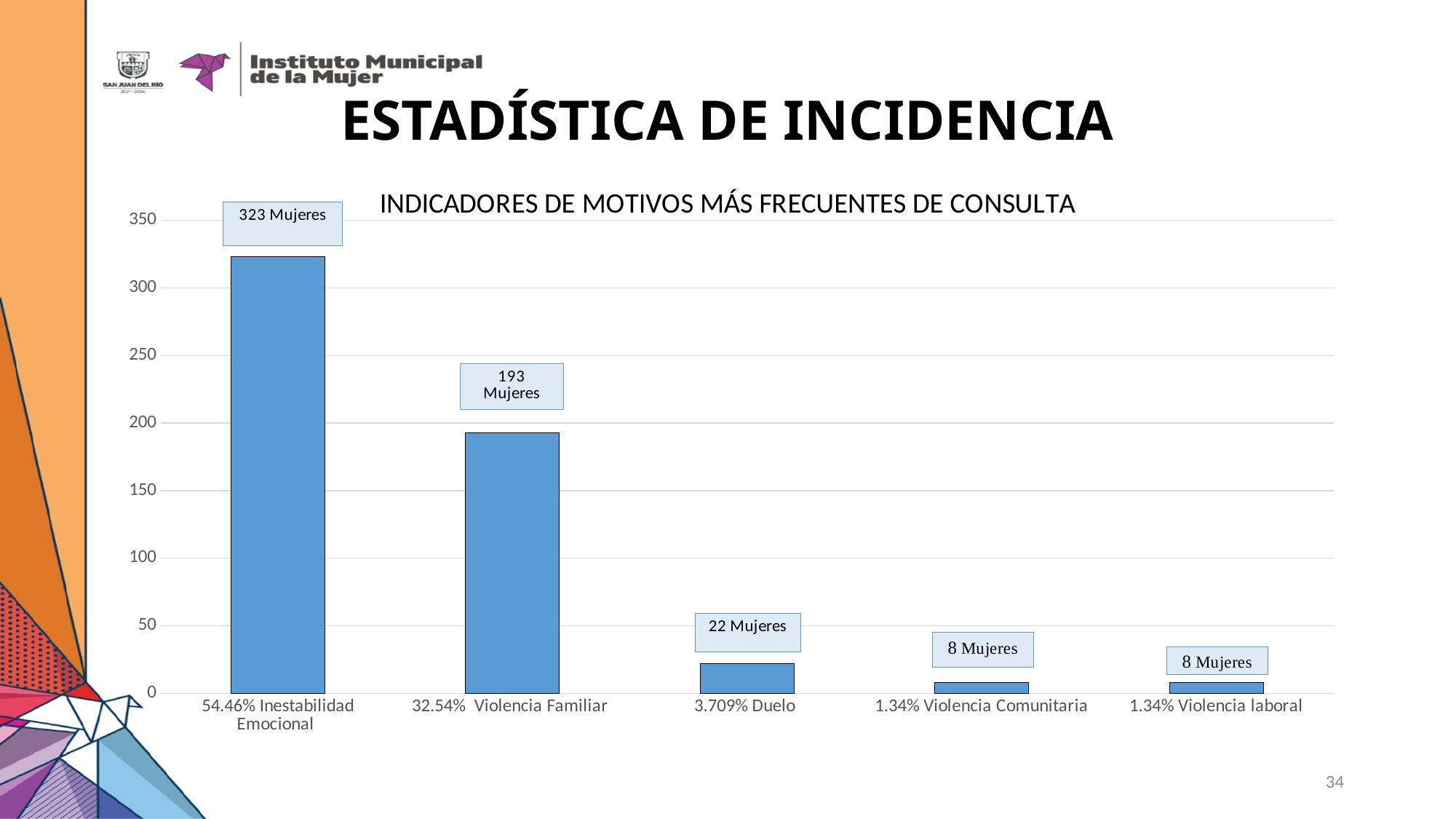
What is the title of the chart? INDICADORES DE MOTIVOS MÁS FRECUENTES DE CONSULTA Is the value for Violencia Familiar greater or less than 150? greater What is the value shown for Inestabilidad Emocional? 323 Mujeres How many categories are shown on the x axis? 5 What kind of chart is shown on the slide? Bar chart What is the difference between the values for Inestabilidad Emocional and Violencia Familiar? 130 What is the value shown for Violencia Familiar? 193 Mujeres Do the values rise or fall from left to right along the x axis? Fall Which is larger, the value for Violencia Familiar or the value for Duelo? Violencia Familiar What is the value shown for Duelo? 22 Mujeres What is the value shown for Violencia Comunitaria? 8 Mujeres Which category has the highest value? Inestabilidad Emocional